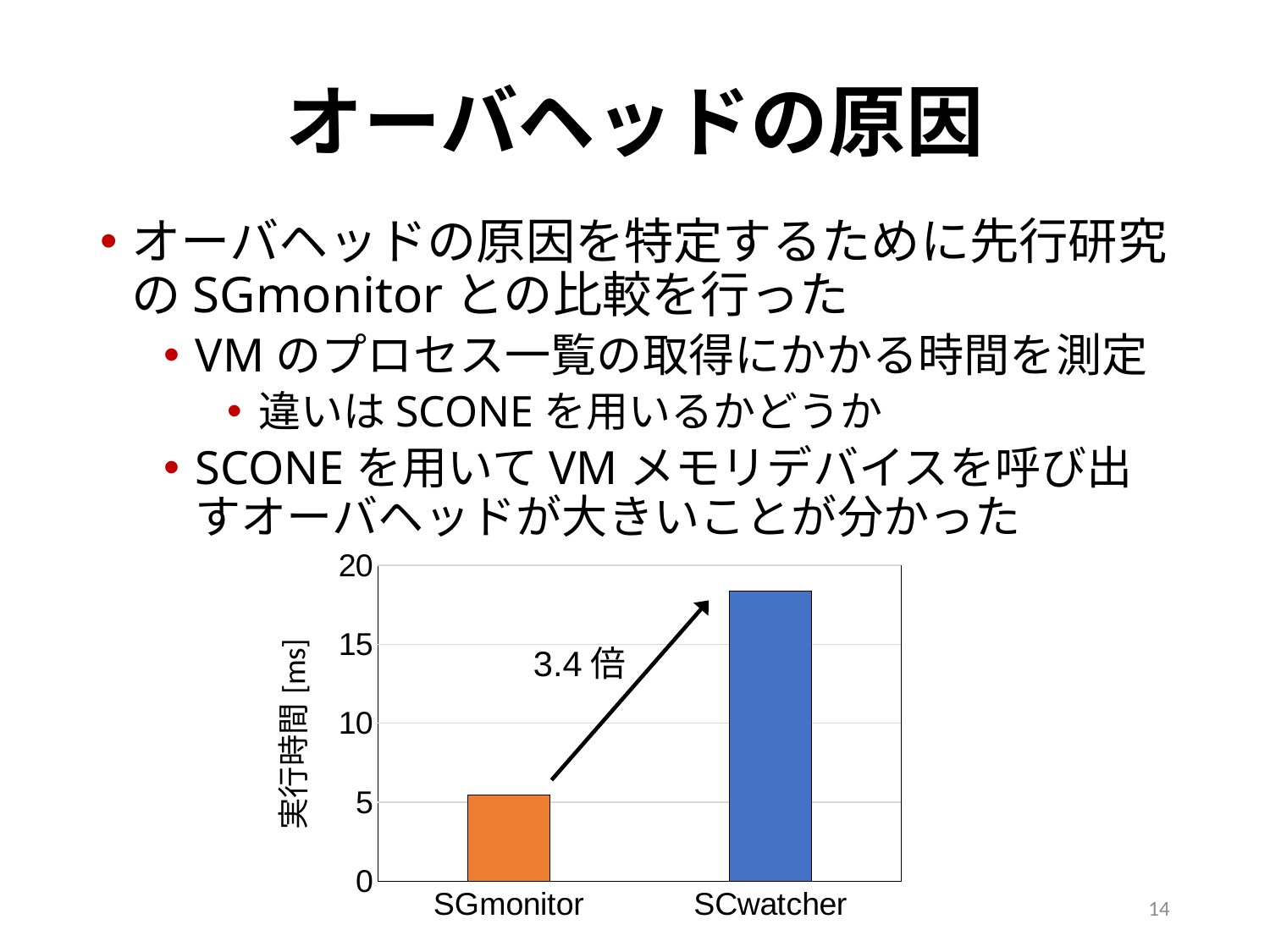
How many bars are plotted in the chart? 2 What ratio is written next to the arrow between the two bars in the chart? 3.4 倍 Is the value for SCwatcher greater or less than 15? greater Which has a larger value in the chart, SGmonitor or SCwatcher? SCwatcher What is the highest tick value shown on the vertical axis of the chart? 20 What kind of chart is shown on the slide? bar chart Which category has the highest execution time in the chart? SCwatcher Which category has the lowest execution time in the chart? SGmonitor Is the value for SCwatcher greater or less than 20? less Is the value for SGmonitor greater or less than 10? less What is the label of the vertical axis of the chart? 実行時間 [ms]